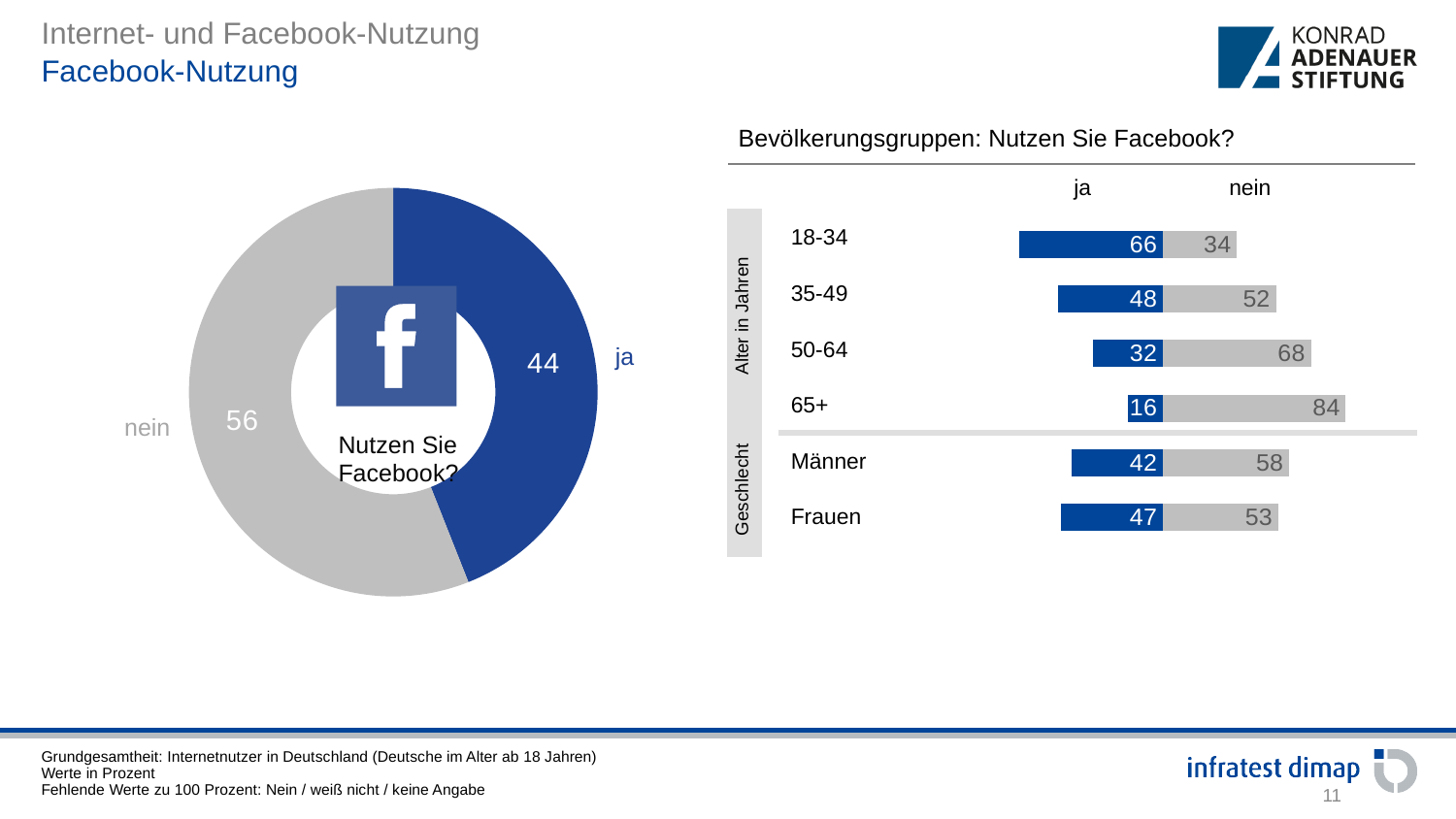
In the donut chart on the left, what is the value for "nein"? 56 In the bar chart "Bevölkerungsgruppen: Nutzen Sie Facebook?", do the "ja" values rise or fall as the age groups get older? Fall In the donut chart on the left, what is the value for "ja"? 44 In the bar chart "Bevölkerungsgruppen: Nutzen Sie Facebook?", which is larger: the "ja" value for 35-49 or the "ja" value for 50-64? 35-49 In the bar chart "Bevölkerungsgruppen: Nutzen Sie Facebook?", which group has the highest "ja" value? 18-34 In the bar chart "Bevölkerungsgruppen: Nutzen Sie Facebook?", what is the difference between the "ja" values for Frauen and Männer? 5 In the bar chart "Bevölkerungsgruppen: Nutzen Sie Facebook?", which group has the lowest "ja" value? 65+ How many series does the bar chart "Bevölkerungsgruppen: Nutzen Sie Facebook?" show? 2 What kind of chart is the chart on the left of the slide? Donut (pie) chart In the bar chart "Bevölkerungsgruppen: Nutzen Sie Facebook?", what is the "ja" value for the 18-34 age group? 66 In the bar chart "Bevölkerungsgruppen: Nutzen Sie Facebook?", what is the "nein" value for the 65+ age group? 84 How many groups (categories) are shown in the bar chart "Bevölkerungsgruppen: Nutzen Sie Facebook?"? 6